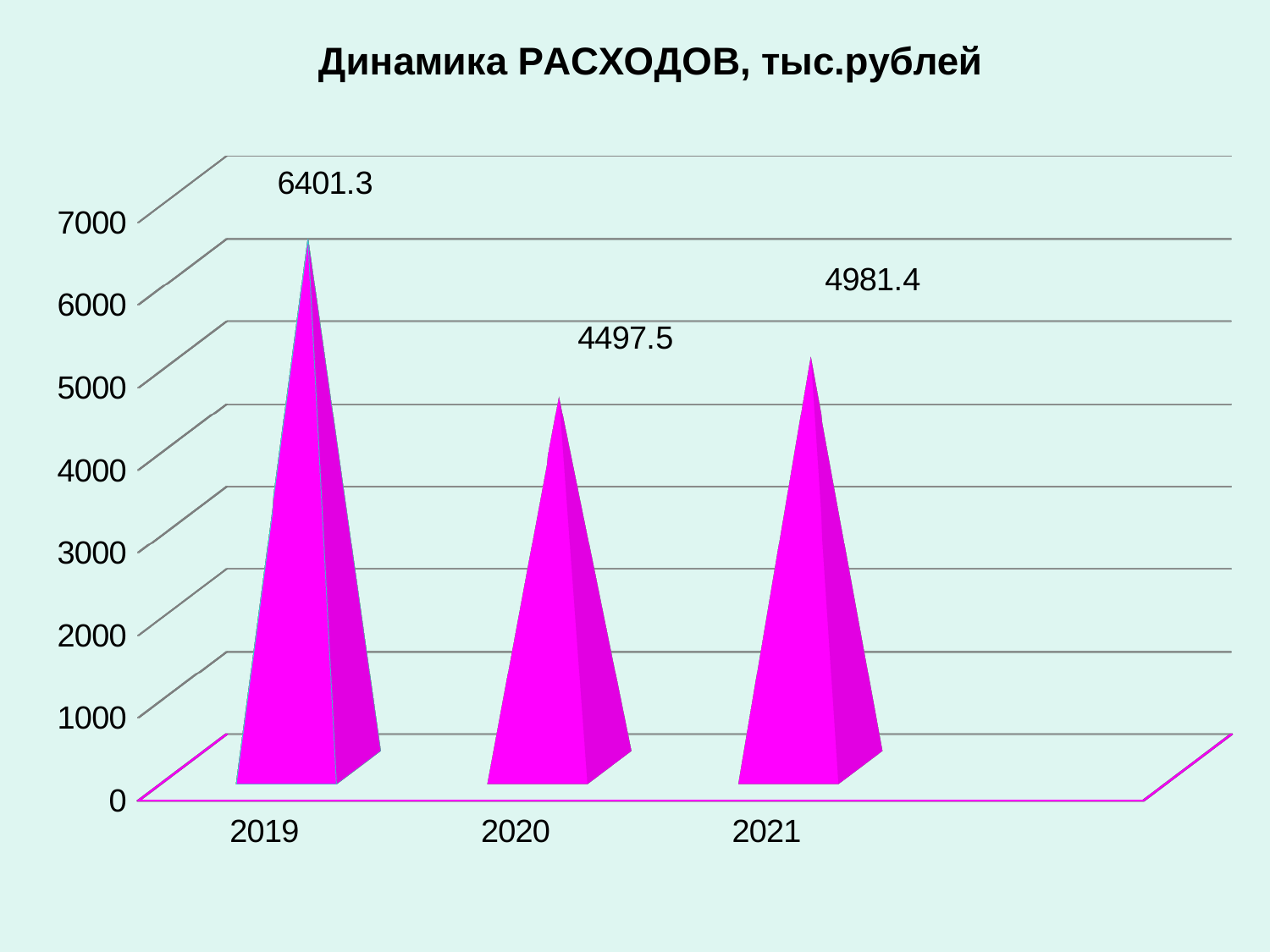
How many years are shown on the chart? 3 Is the value for 2019 greater or less than 6000? greater What is the title of the chart? Динамика РАСХОДОВ, тыс.рублей What kind of chart is shown on the slide? bar chart What is the difference between the values for 2021 and 2020? 483.9 What is the difference between the values for 2019 and 2020? 1903.8 Which year has the highest value? 2019 Which year has the lowest value? 2020 What is the value for 2019? 6401.3 What is the value for 2021? 4981.4 What is the value for 2020? 4497.5 Which is larger, the value for 2020 or the value for 2021? 2021